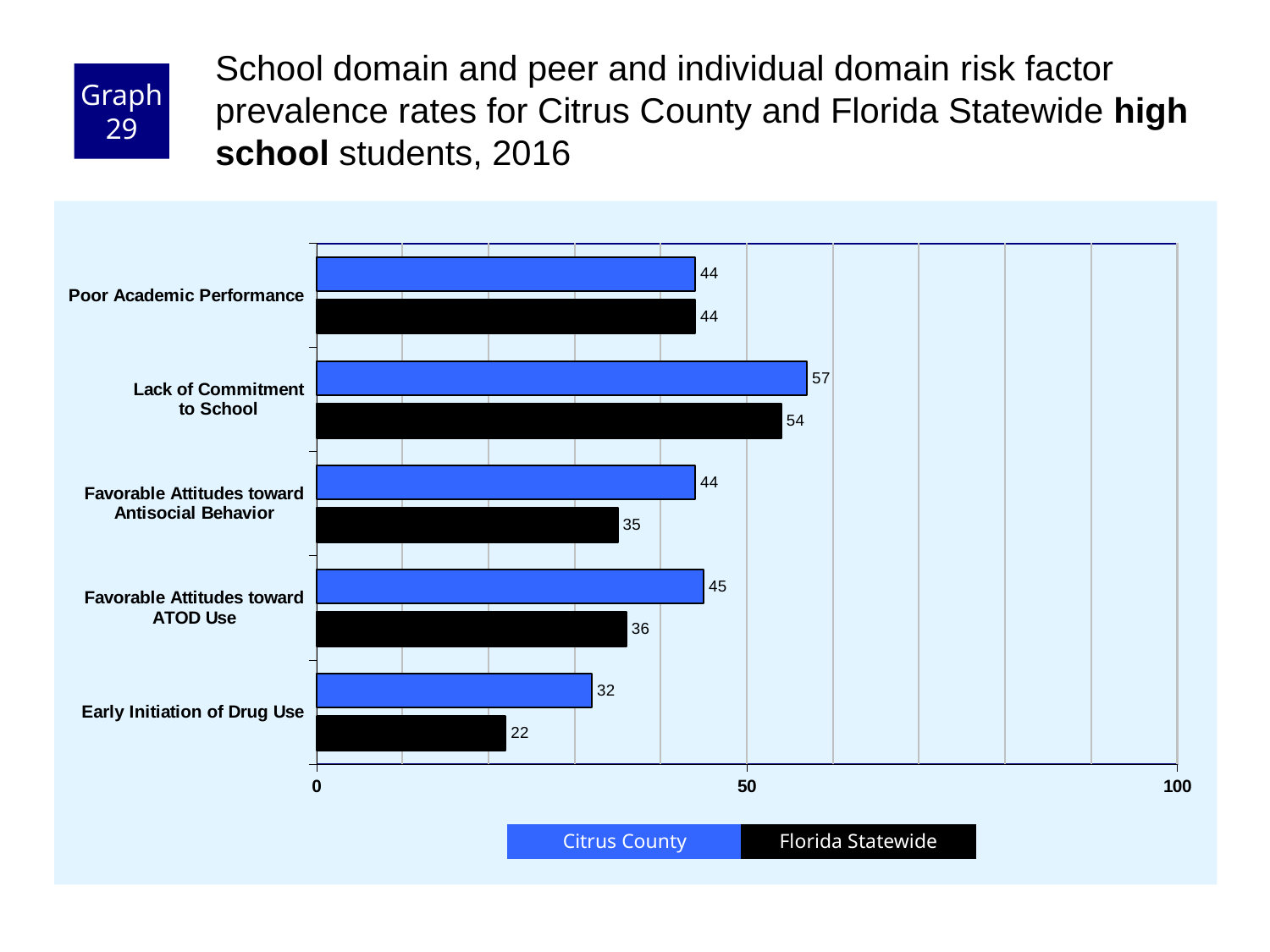
Which is larger for Favorable Attitudes toward Antisocial Behavior: the Citrus County value or the Florida Statewide value? Citrus County What is the Citrus County value for Lack of Commitment to School? 57 Is the Citrus County value for Lack of Commitment to School greater or less than 50? greater What is the Florida Statewide value for Early Initiation of Drug Use? 22 Which category has the highest Citrus County value? Lack of Commitment to School What is the Florida Statewide value for Favorable Attitudes toward Antisocial Behavior? 35 Which category has the lowest Florida Statewide value? Early Initiation of Drug Use What is the difference between the Citrus County and Florida Statewide values for Early Initiation of Drug Use? 10 How many risk factor categories are shown on the chart? 5 What kind of chart is shown on the slide? bar chart How many series does the legend list? 2 What is the difference between the Citrus County and Florida Statewide values for Favorable Attitudes toward ATOD Use? 9